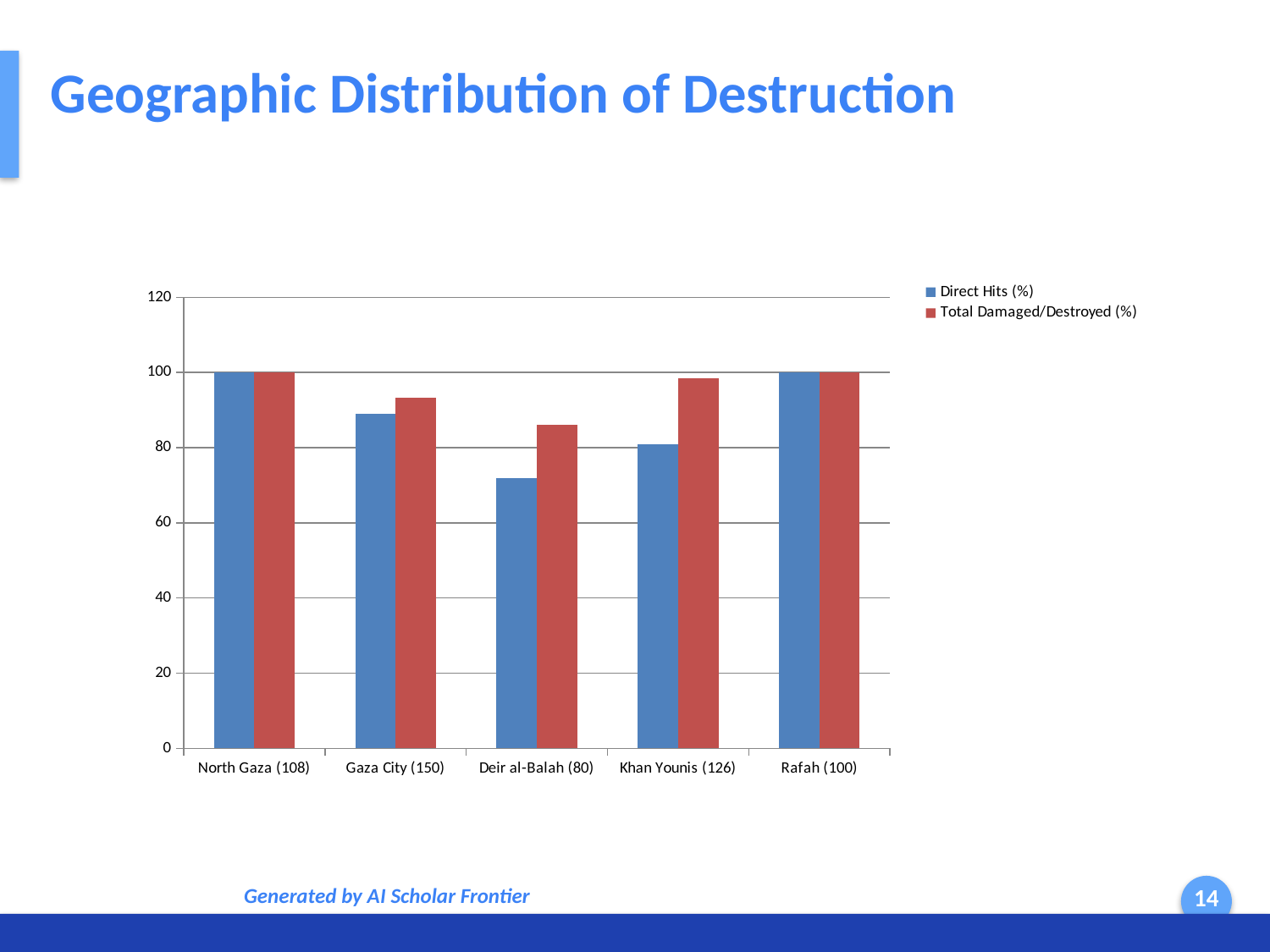
Is the Direct Hits (%) value for Gaza City (150) greater or less than 80? greater What kind of chart is shown on the slide? Bar chart Is the Direct Hits (%) value for Deir al-Balah (80) greater or less than 80? less How many series does the chart's legend list? 2 Which region has the lowest Total Damaged/Destroyed (%) value? Deir al-Balah (80) Which is larger: the Direct Hits (%) value for Gaza City (150) or for Deir al-Balah (80)? Gaza City (150) For Deir al-Balah (80), which series has the larger value: Direct Hits (%) or Total Damaged/Destroyed (%)? Total Damaged/Destroyed (%) Which region has the lowest Direct Hits (%) value? Deir al-Balah (80) What is the Total Damaged/Destroyed (%) value for Rafah (100)? 100 What are the two series named in the legend? Direct Hits (%) and Total Damaged/Destroyed (%) What is the Direct Hits (%) value for North Gaza (108)? 100 How many regions are shown on the x axis of the chart? 5